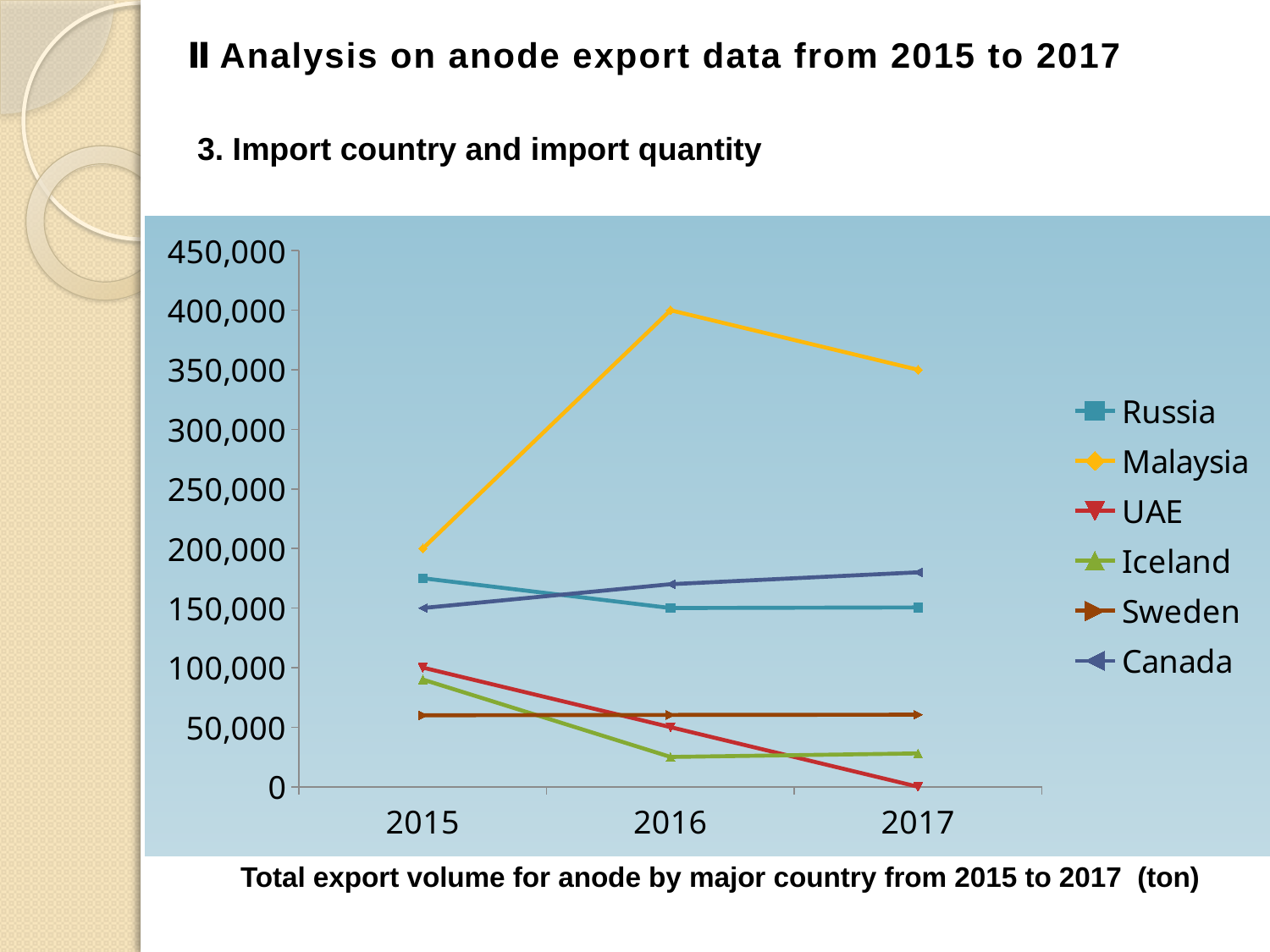
By how much did Malaysia's export volume fall from 2016 to 2017? 50,000 What was the export volume for Malaysia in 2017? 350,000 What was the export volume for Malaysia in 2016? 400,000 Is the value for Russia in 2015 greater or less than 150,000? greater How many series does the legend list? 6 Which country had the lowest export volume in 2017? UAE Did Canada's export volume rise or fall from 2015 to 2017? Rise Which country had the highest export volume in 2016? Malaysia How many years are shown on the x axis? 3 Is the value for Sweden in 2016 greater or less than 50,000? greater In 2017, which is larger, the value for Russia or the value for Canada? Canada What kind of chart is shown on the slide? Line chart